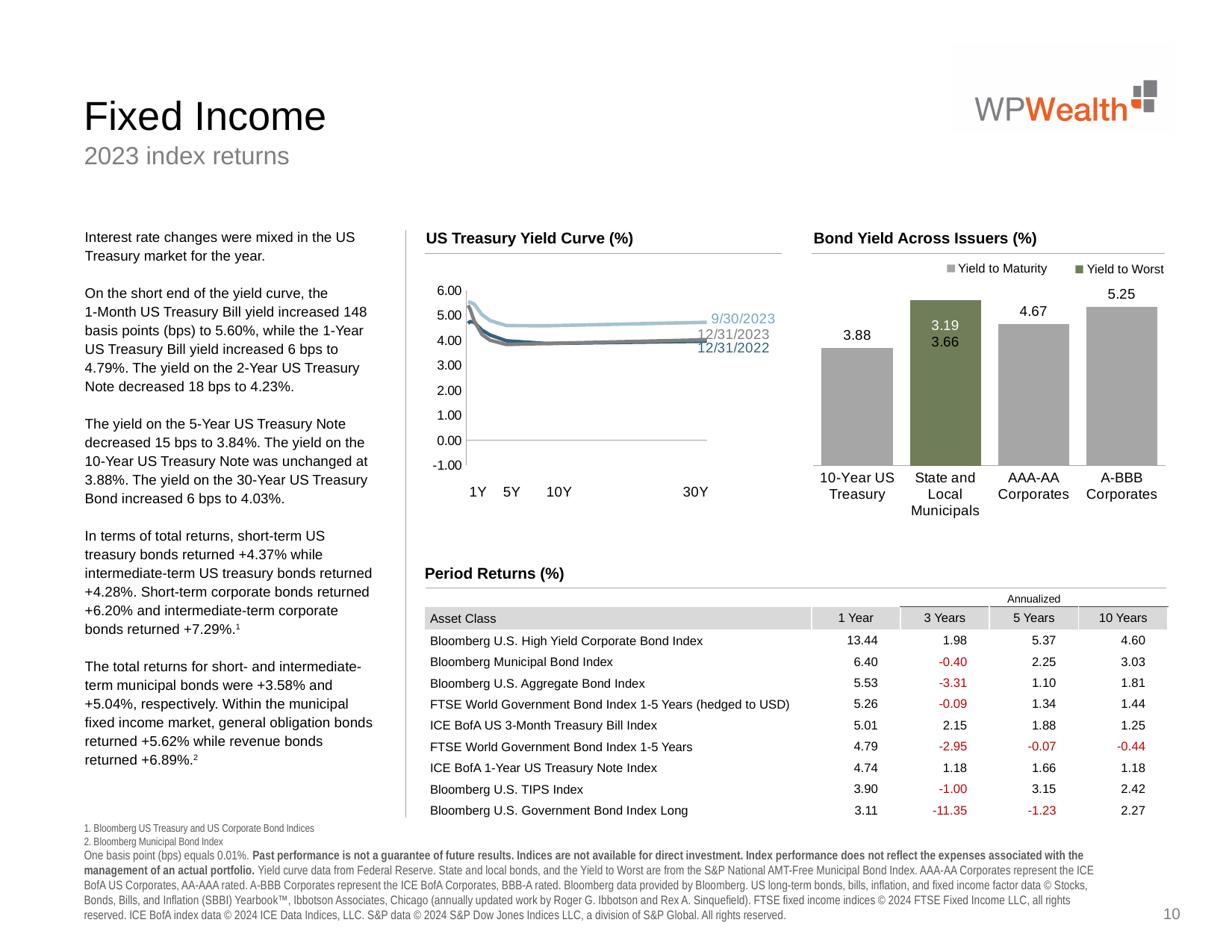
How many issuer categories are shown in the Bond Yield Across Issuers (%) chart? 4 In the Bond Yield Across Issuers (%) chart, what is the value for 10-Year US Treasury? 3.88 In the Bond Yield Across Issuers (%) chart, what is the value for AAA-AA Corporates? 4.67 In the US Treasury Yield Curve (%) chart, is the 9/30/2023 value at 1Y greater or less than 5.00? greater How many dated series are plotted in the US Treasury Yield Curve (%) chart? 3 What kind of chart is the US Treasury Yield Curve (%) chart? Line chart How many series does the legend of the Bond Yield Across Issuers (%) chart list? 2 In the Bond Yield Across Issuers (%) chart, what is the difference between the A-BBB Corporates value and the 10-Year US Treasury value? 1.37 What kind of chart is the Bond Yield Across Issuers (%) chart? Bar chart In the Bond Yield Across Issuers (%) chart, which issuer category has the highest bar? A-BBB Corporates In the Bond Yield Across Issuers (%) chart, which is larger: the value for AAA-AA Corporates or the value for 10-Year US Treasury? AAA-AA Corporates In the Bond Yield Across Issuers (%) chart, what is the value for A-BBB Corporates? 5.25